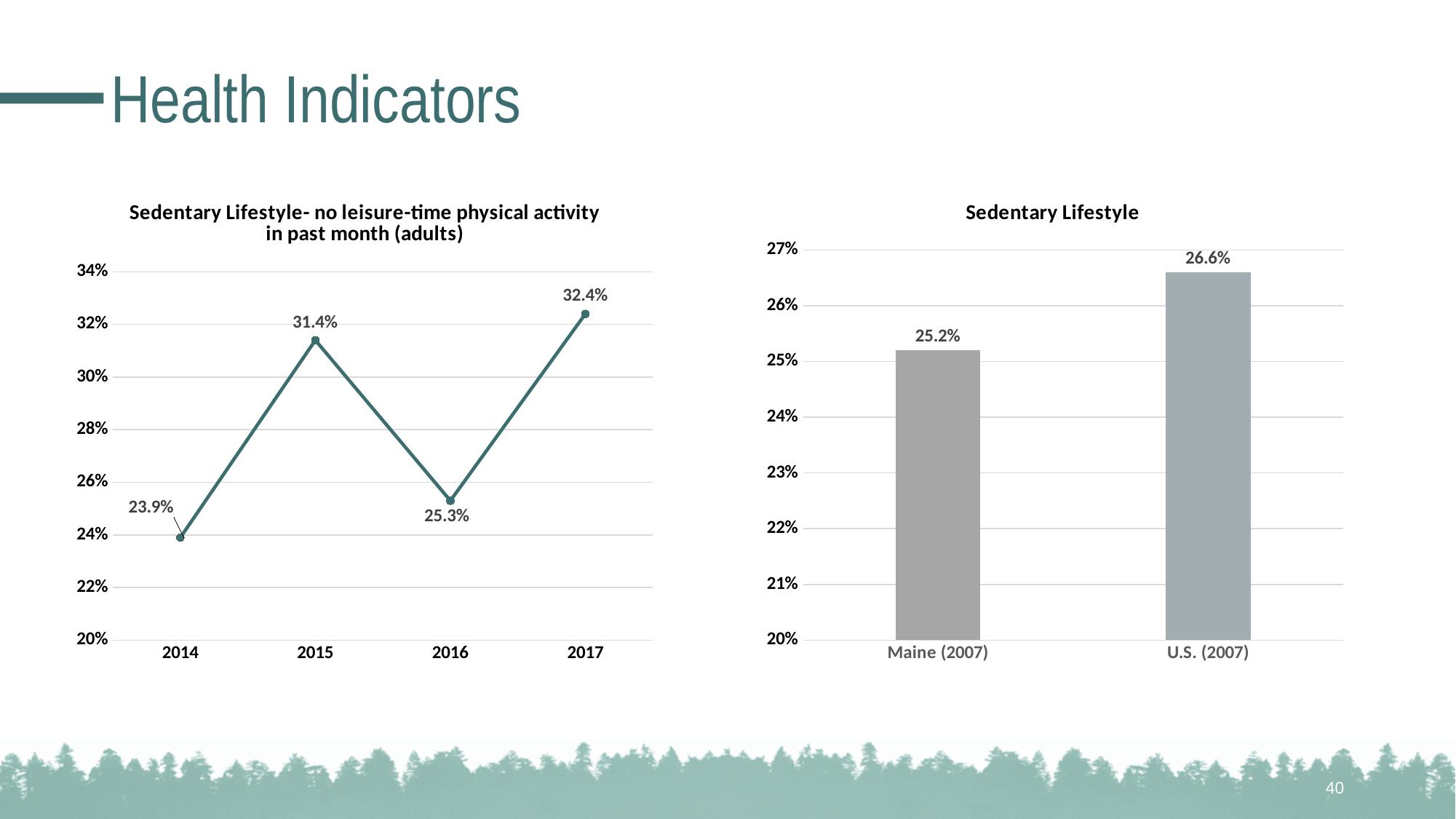
In the right chart (Sedentary Lifestyle), which is larger, Maine (2007) or U.S. (2007)? U.S. (2007) What kind of chart is the left chart (Sedentary Lifestyle- no leisure-time physical activity in past month (adults))? Line chart In the right chart (Sedentary Lifestyle), what is the difference between the U.S. (2007) and Maine (2007) values? 1.4% In the right chart (Sedentary Lifestyle), what is the value for U.S. (2007)? 26.6% In the left chart (Sedentary Lifestyle- no leisure-time physical activity in past month (adults)), how many years are plotted? 4 In the left chart (Sedentary Lifestyle- no leisure-time physical activity in past month (adults)), what is the value for 2015? 31.4% In the left chart (Sedentary Lifestyle- no leisure-time physical activity in past month (adults)), what is the difference between the 2017 and 2016 values? 7.1% In the right chart (Sedentary Lifestyle), what is the value for Maine (2007)? 25.2% What kind of chart is the right chart (Sedentary Lifestyle)? Bar chart In the left chart (Sedentary Lifestyle- no leisure-time physical activity in past month (adults)), which year has the lowest value? 2014 In the left chart (Sedentary Lifestyle- no leisure-time physical activity in past month (adults)), what is the value for 2014? 23.9% In the left chart (Sedentary Lifestyle- no leisure-time physical activity in past month (adults)), which year has the highest value? 2017